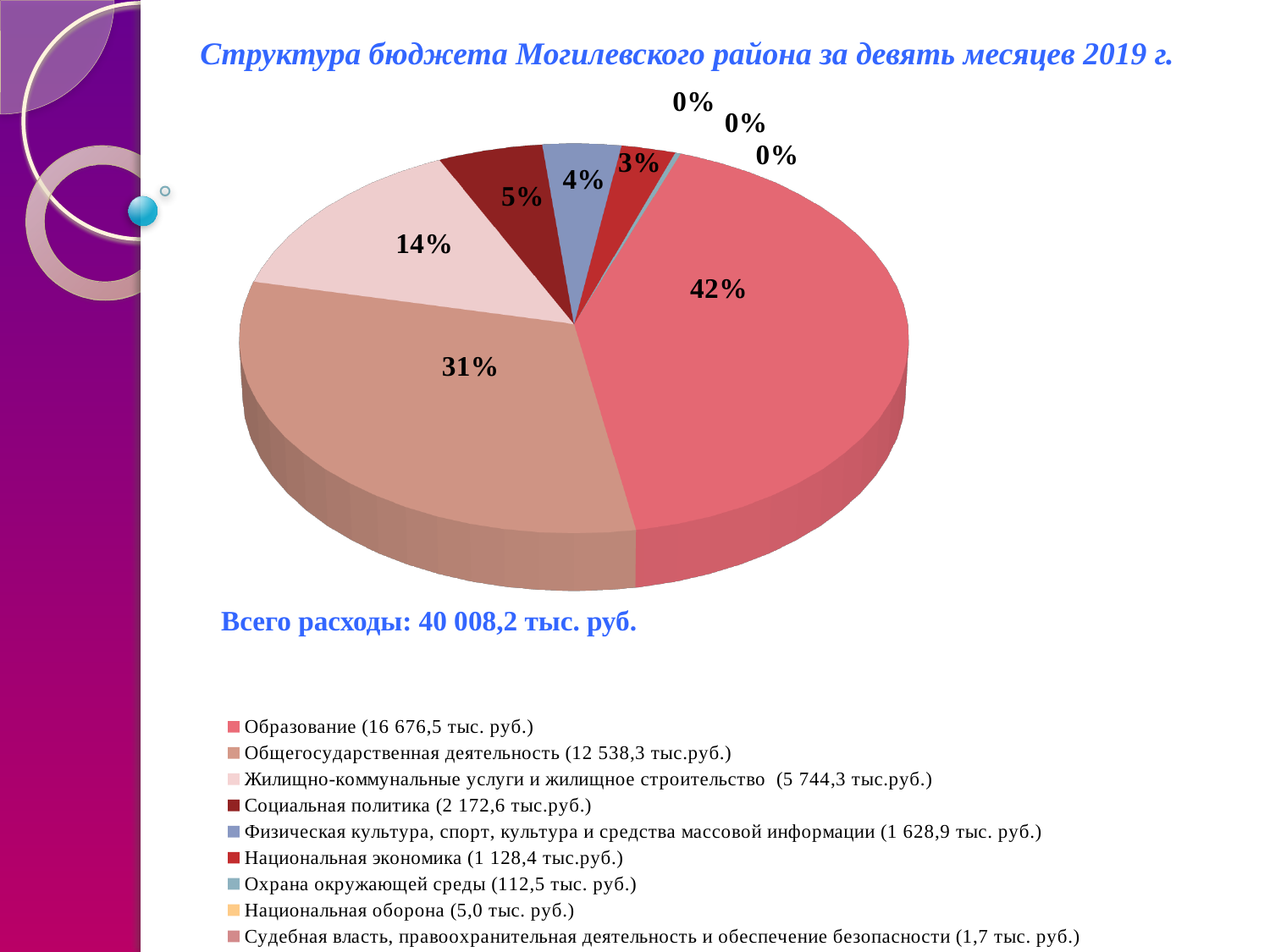
What share of the budget does Образование account for? 42% What kind of chart is shown on the slide? Pie chart Which has a larger share: Жилищно-коммунальные услуги и жилищное строительство or Социальная политика? Жилищно-коммунальные услуги и жилищное строительство Which category has the largest share of the pie? Образование What share of the budget does Физическая культура, спорт, культура и средства массовой информации account for? 4% According to the legend, what is the amount for Социальная политика? 2 172,6 тыс.руб. How many categories does the legend list? 9 What share of the budget does Национальная экономика account for? 3% According to the legend, what is the amount for Охрана окружающей среды? 112,5 тыс. руб. What share of the budget does Общегосударственная деятельность account for? 31% What total expenditure is stated below the chart? 40 008,2 тыс. руб. What is the difference in percentage points between the shares of Образование and Общегосударственная деятельность? 11 percentage points